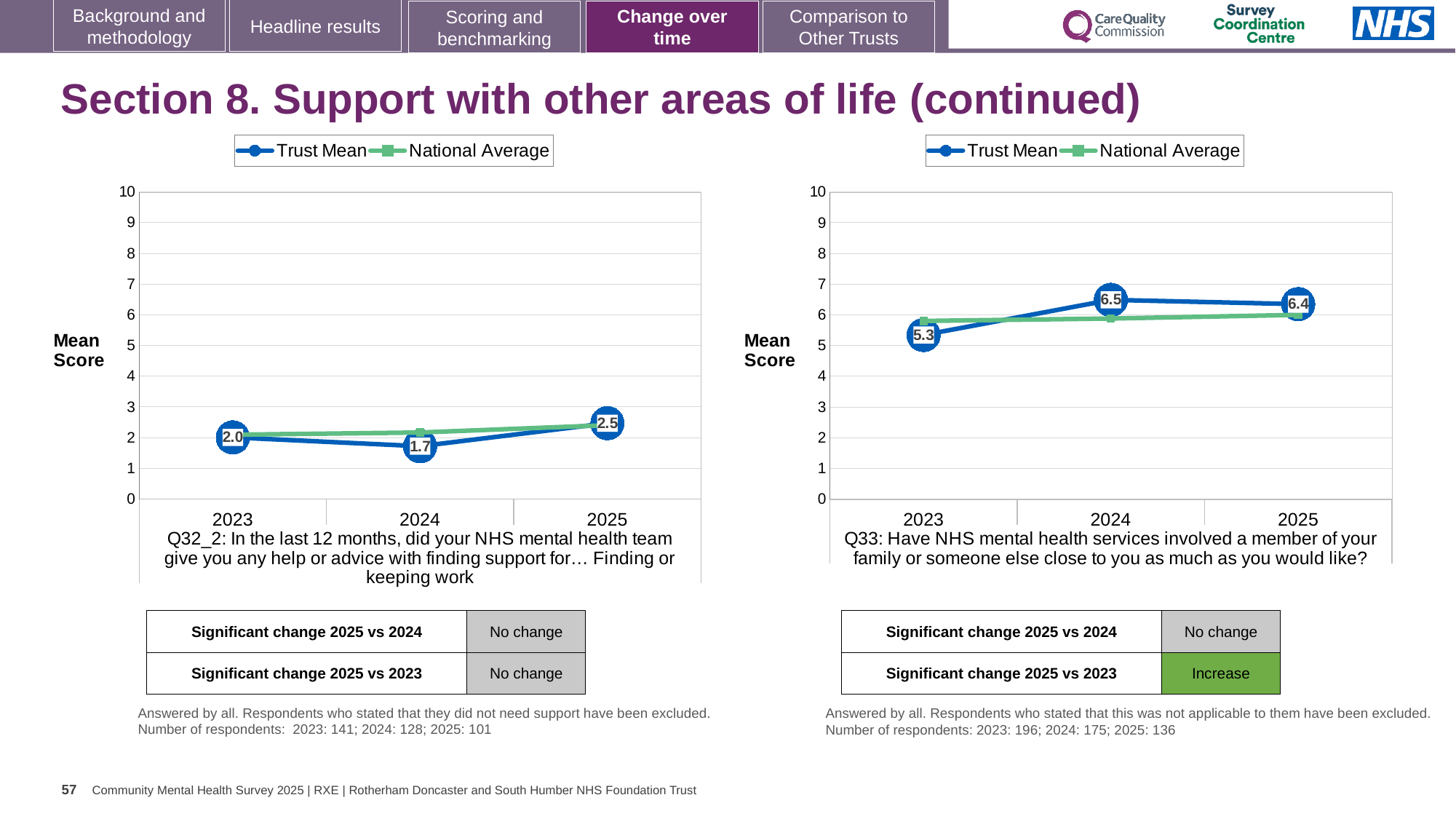
In the right chart (Q33), does the Trust Mean rise or fall from 2023 to 2024? Rise In the left chart (Q32_2), which year has the lowest Trust Mean? 2024 In the right chart (Q33), is the National Average for 2025 greater or less than 5? greater What type of chart is the right chart (Q33)? Line chart In the left chart (Q32_2), for 2024, which is larger: the Trust Mean or the National Average? National Average In the right chart (Q33), which year has the highest Trust Mean? 2024 In the right chart (Q33), what is the difference between the Trust Mean in 2024 and in 2023? 1.2 In the left chart (Q32_2), what is the Trust Mean for 2025? 2.5 How many years are shown on the x axis of the right chart (Q33)? 3 In the right chart (Q33), what is the Trust Mean for 2023? 5.3 In the left chart (Q32_2), what is the difference between the Trust Mean in 2025 and in 2024? 0.8 How many series does the legend of the left chart (Q32_2) list? 2